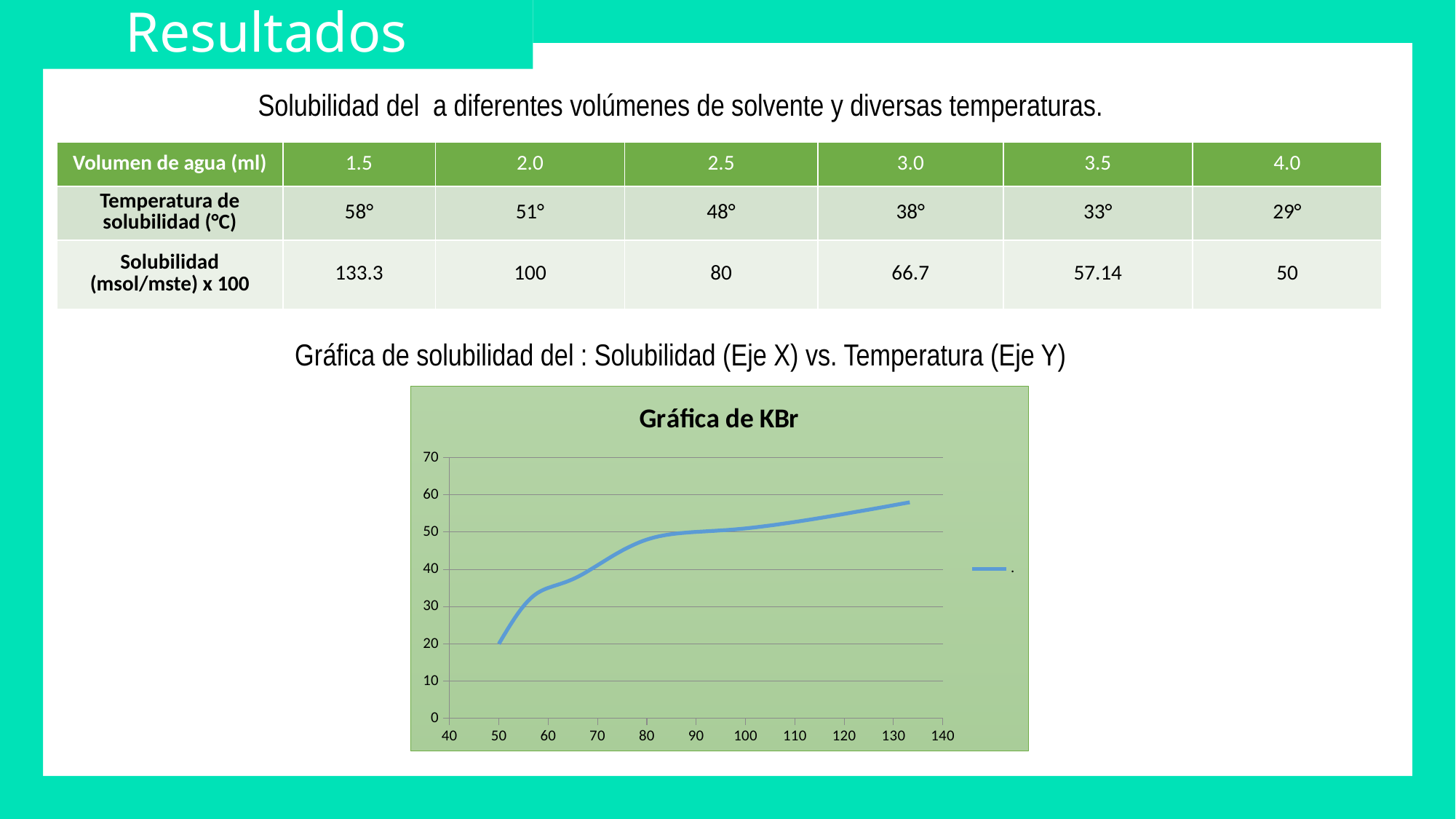
Do the values on the chart rise or fall as you move from left to right along the x axis? rise Is the value of the line at x = 90 greater or less than 60? less How many series does the chart's legend list? 1 Is the value of the line at x = 60 greater or less than 40? less What kind of chart is shown on the slide? line chart Is the value of the line at x = 100 greater or less than 40? greater What is the title of the chart? Gráfica de KBr What is the highest tick value shown on the y axis of the chart? 70